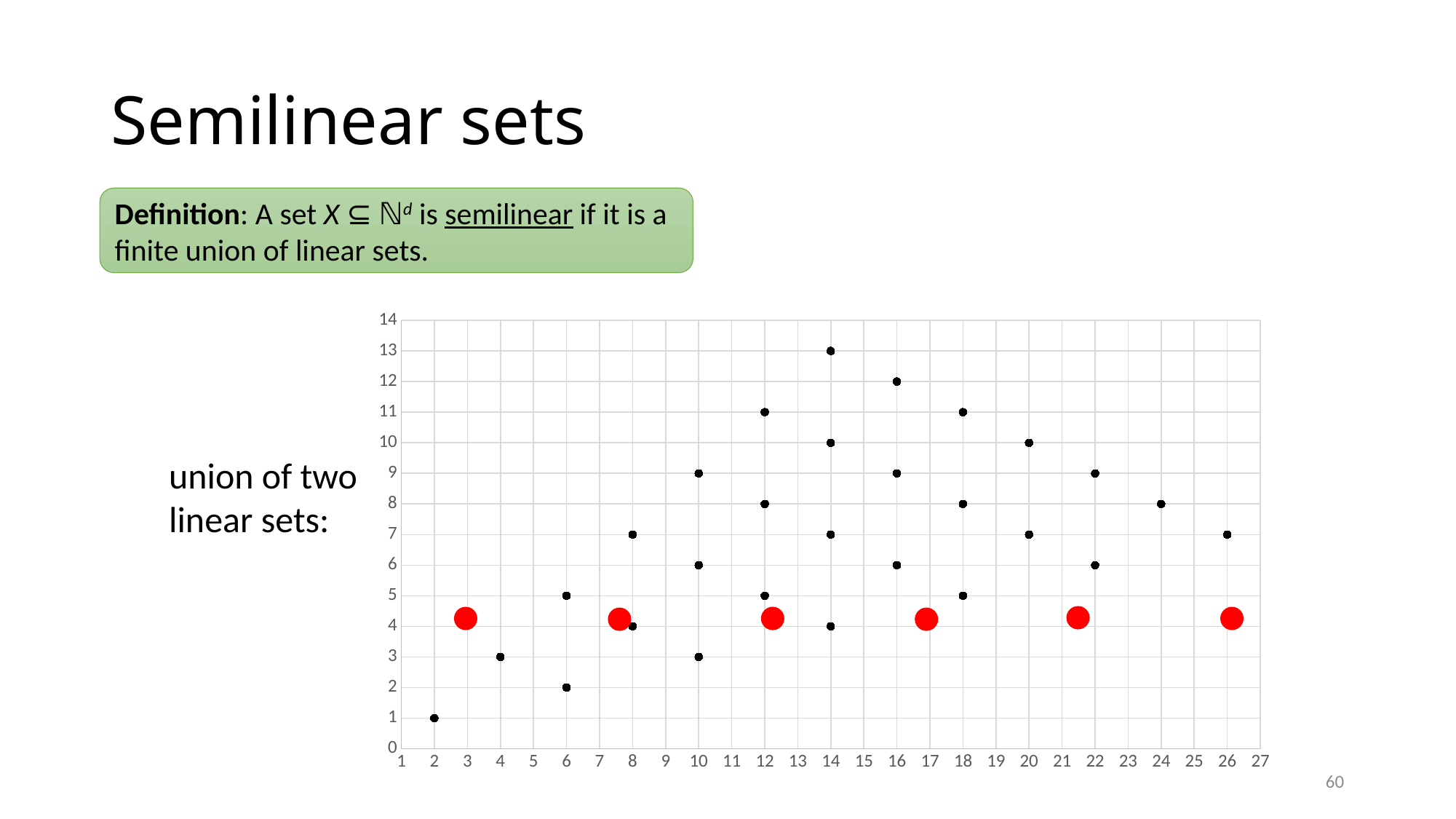
What is the largest value labelled on the x axis? 27 What is the y value of the black point at x = 24? 8 What is the y value of the highest black point on the chart? 13 How many large red points are plotted on the chart? 6 What kind of chart is shown on the slide? scatter plot What is the y value of the black point at x = 26? 7 At which x value does the highest black point (y = 13) appear? 14 What is the y value of the lowest black point on the chart? 1 What is the y value of the black point at x = 2? 1 How many black points are plotted at x = 14? 4 Which has the higher topmost black point: x = 12 or x = 16? x = 16